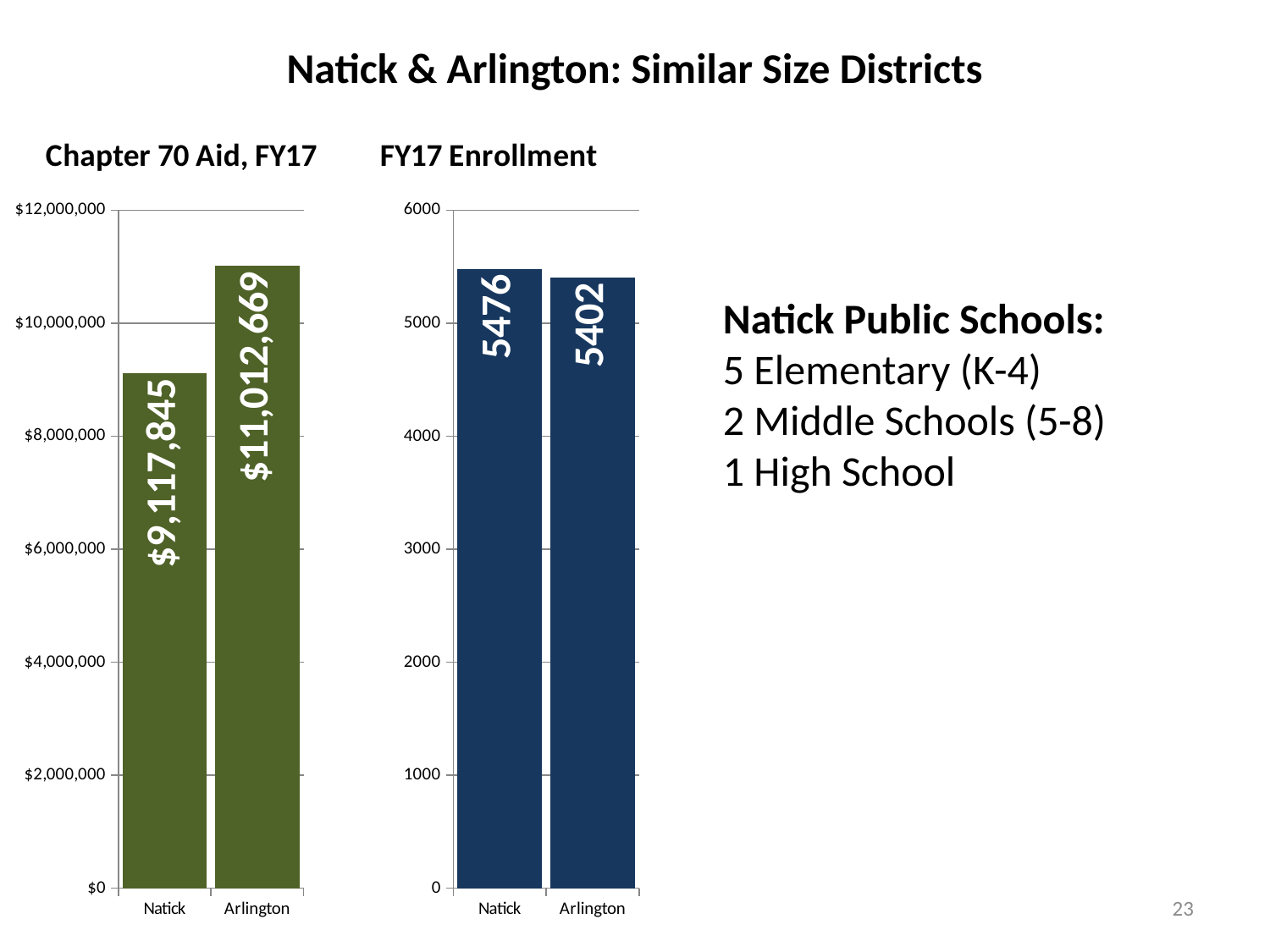
In the Chapter 70 Aid, FY17 chart, which district receives the most aid? Arlington In the FY17 Enrollment chart, what is the enrollment for Arlington? 5402 In the FY17 Enrollment chart, what is the enrollment for Natick? 5476 How many districts are shown in the FY17 Enrollment chart? 2 In the Chapter 70 Aid, FY17 chart, what is the difference between Arlington's and Natick's aid? $1,894,824 In the Chapter 70 Aid, FY17 chart, is the value for Natick greater or less than $10,000,000? less What type of chart is the Chapter 70 Aid, FY17 chart? Bar chart In the FY17 Enrollment chart, which district has the larger enrollment, Natick or Arlington? Natick In the FY17 Enrollment chart, what is the difference between Natick's and Arlington's enrollment? 74 In the FY17 Enrollment chart, which district has the lower enrollment? Arlington In the Chapter 70 Aid, FY17 chart, what is the value for Natick? $9,117,845 In the Chapter 70 Aid, FY17 chart, what is the value for Arlington? $11,012,669